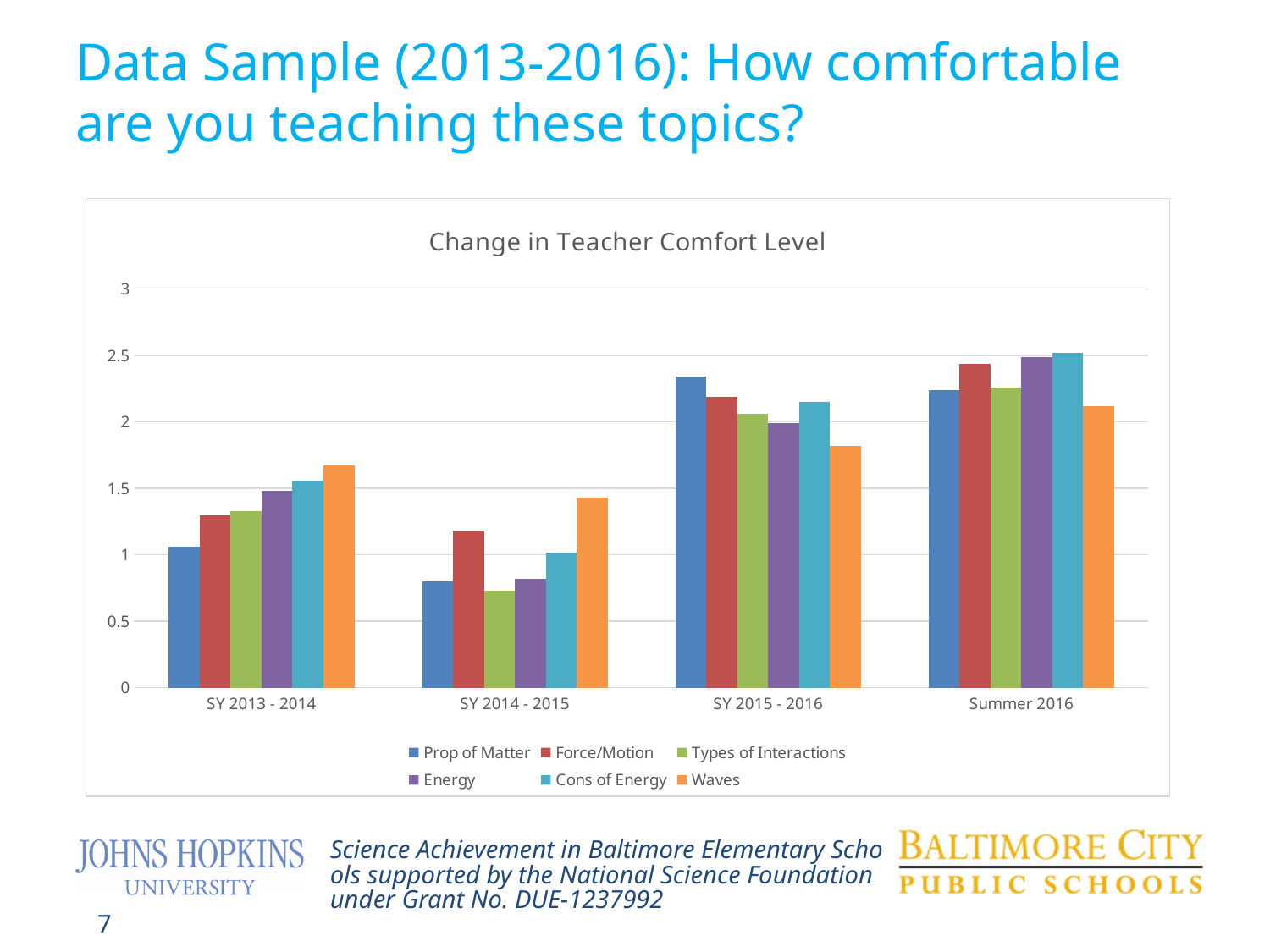
What is the title of the chart? Change in Teacher Comfort Level Which series has the lowest value in SY 2013 - 2014? Prop of Matter Is the value for Prop of Matter in SY 2015 - 2016 greater or less than 2? greater Is the value for Waves in SY 2013 - 2014 greater or less than 1.5? greater How many categories are shown along the x axis of the chart? 4 Which series has the highest value in SY 2015 - 2016? Prop of Matter What kind of chart is shown on the slide? Bar chart Which series has the lowest value in SY 2015 - 2016? Waves How many series does the legend of the chart list? 6 Is the value for Waves larger in SY 2015 - 2016 or in Summer 2016? Summer 2016 Is the value for Types of Interactions in SY 2014 - 2015 greater or less than 1? less Which series has the highest value in SY 2014 - 2015? Waves